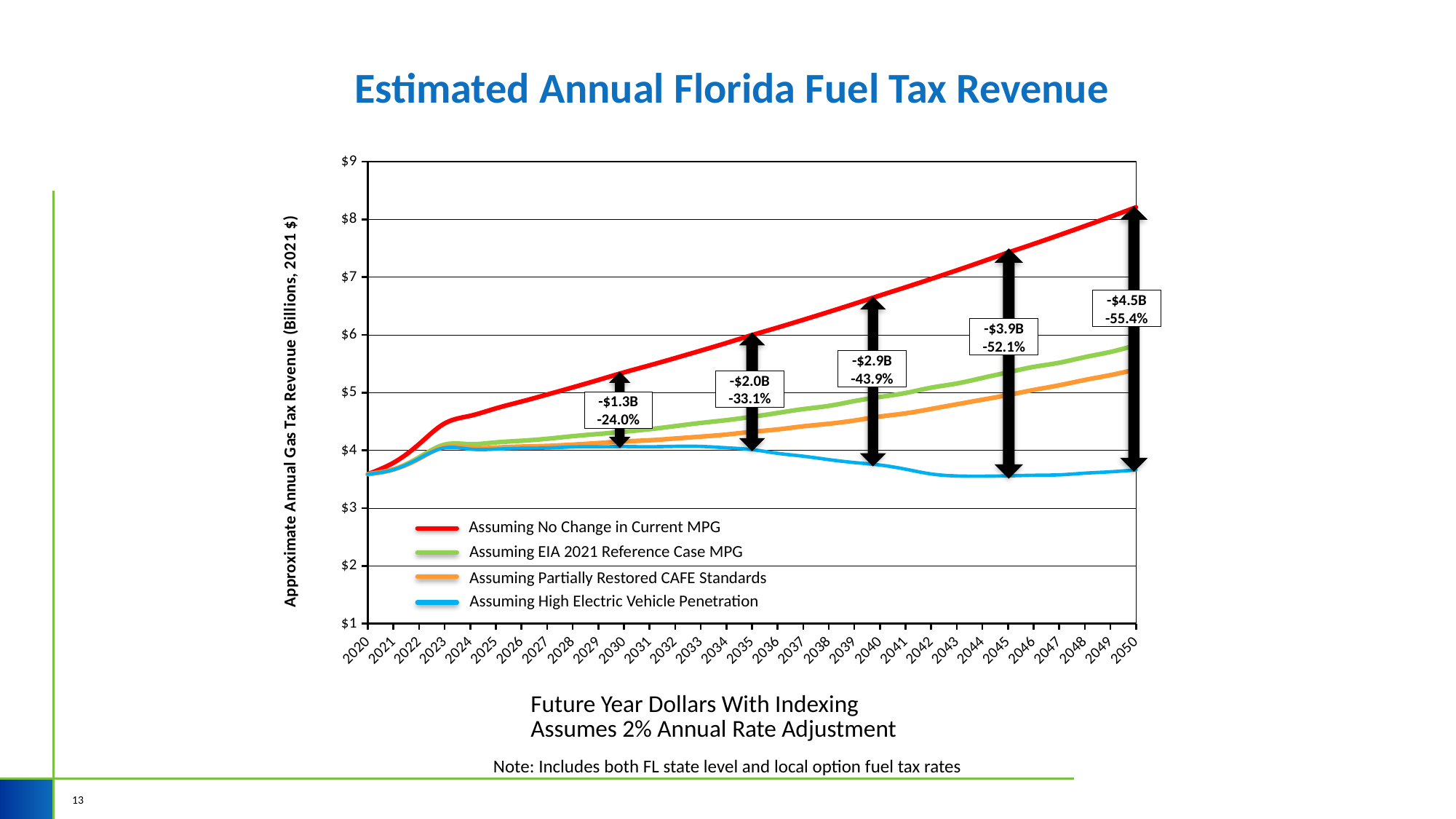
What kind of chart is shown on the slide? Line chart What dollar gap is labelled between the top and bottom lines at 2050? -$4.5B Which series is drawn in red? Assuming No Change in Current MPG What percentage gap is labelled between the top and bottom lines at 2030? -24.0% What dollar gap is labelled at 2040? -$2.9B Is the value for Assuming No Change in Current MPG in 2050 greater or less than $8? greater Which is higher in 2050, Assuming EIA 2021 Reference Case MPG or Assuming Partially Restored CAFE Standards? Assuming EIA 2021 Reference Case MPG What percentage gap is labelled at 2045? -52.1% Does the Assuming No Change in Current MPG line rise or fall from 2020 to 2050? Rise Is the value for Assuming High Electric Vehicle Penetration in 2050 greater or less than $4? less How many series does the legend list? 4 What is the title of the chart? Estimated Annual Florida Fuel Tax Revenue